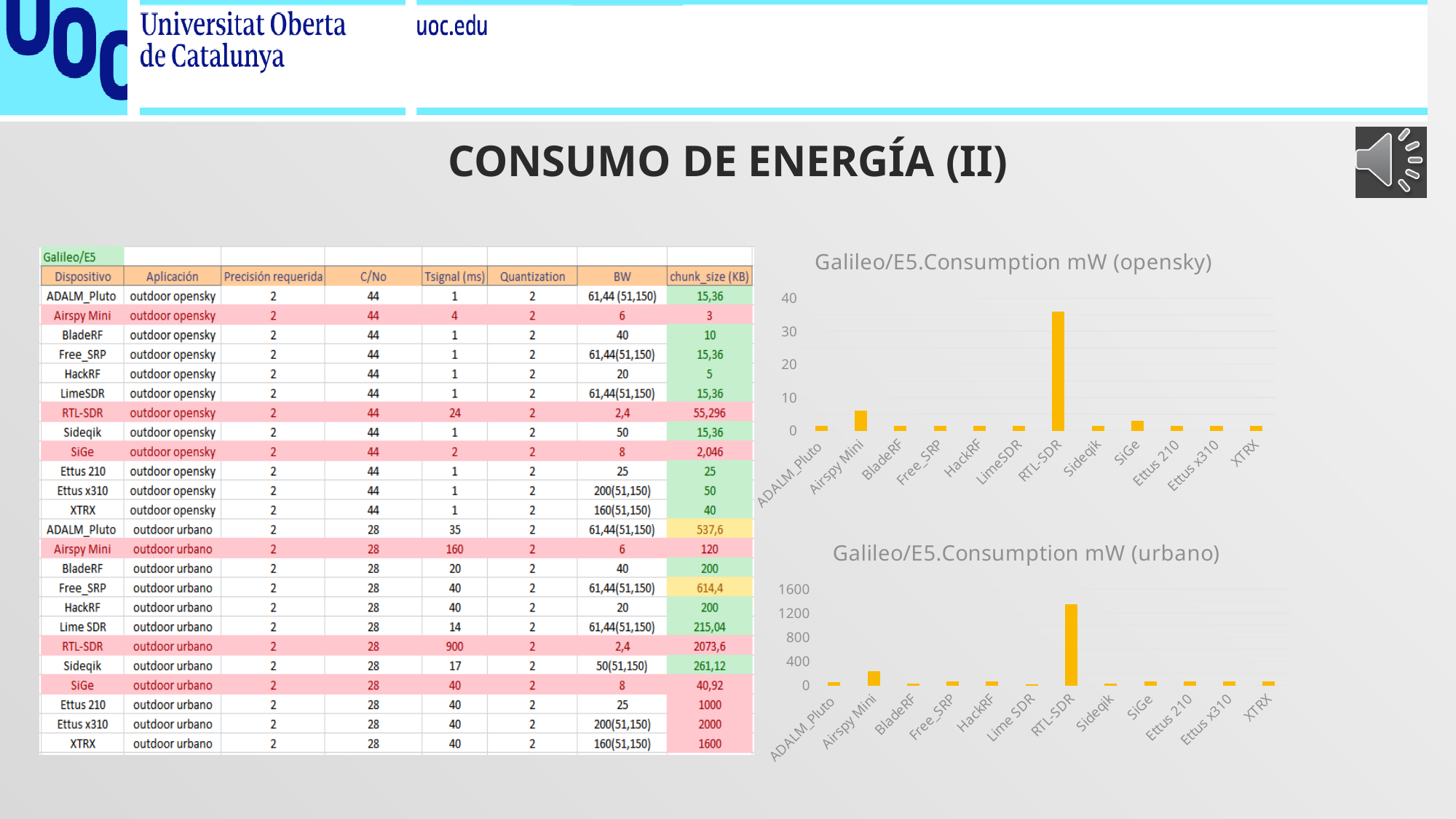
What kind of chart is the 'Galileo/E5.Consumption mW (opensky)' chart? bar chart In the 'Galileo/E5.Consumption mW (opensky)' chart, is the value for RTL-SDR greater or less than 30? greater In the 'Galileo/E5.Consumption mW (opensky)' chart, which is larger, the value for Airspy Mini or the value for BladeRF? Airspy Mini In the 'Galileo/E5.Consumption mW (opensky)' chart, which device has the highest consumption? RTL-SDR In the 'Galileo/E5.Consumption mW (urbano)' chart, is the value for RTL-SDR greater or less than 1200? greater In the 'Galileo/E5.Consumption mW (urbano)' chart, is the value for Airspy Mini greater or less than 400? less How many devices are plotted on the x axis of the 'Galileo/E5.Consumption mW (opensky)' chart? 12 What is the title of the lower chart on the slide? Galileo/E5.Consumption mW (urbano) In the 'Galileo/E5.Consumption mW (urbano)' chart, which device has the highest consumption? RTL-SDR How many devices are plotted on the x axis of the 'Galileo/E5.Consumption mW (urbano)' chart? 12 In the 'Galileo/E5.Consumption mW (urbano)' chart, which is larger, the value for RTL-SDR or the value for Airspy Mini? RTL-SDR